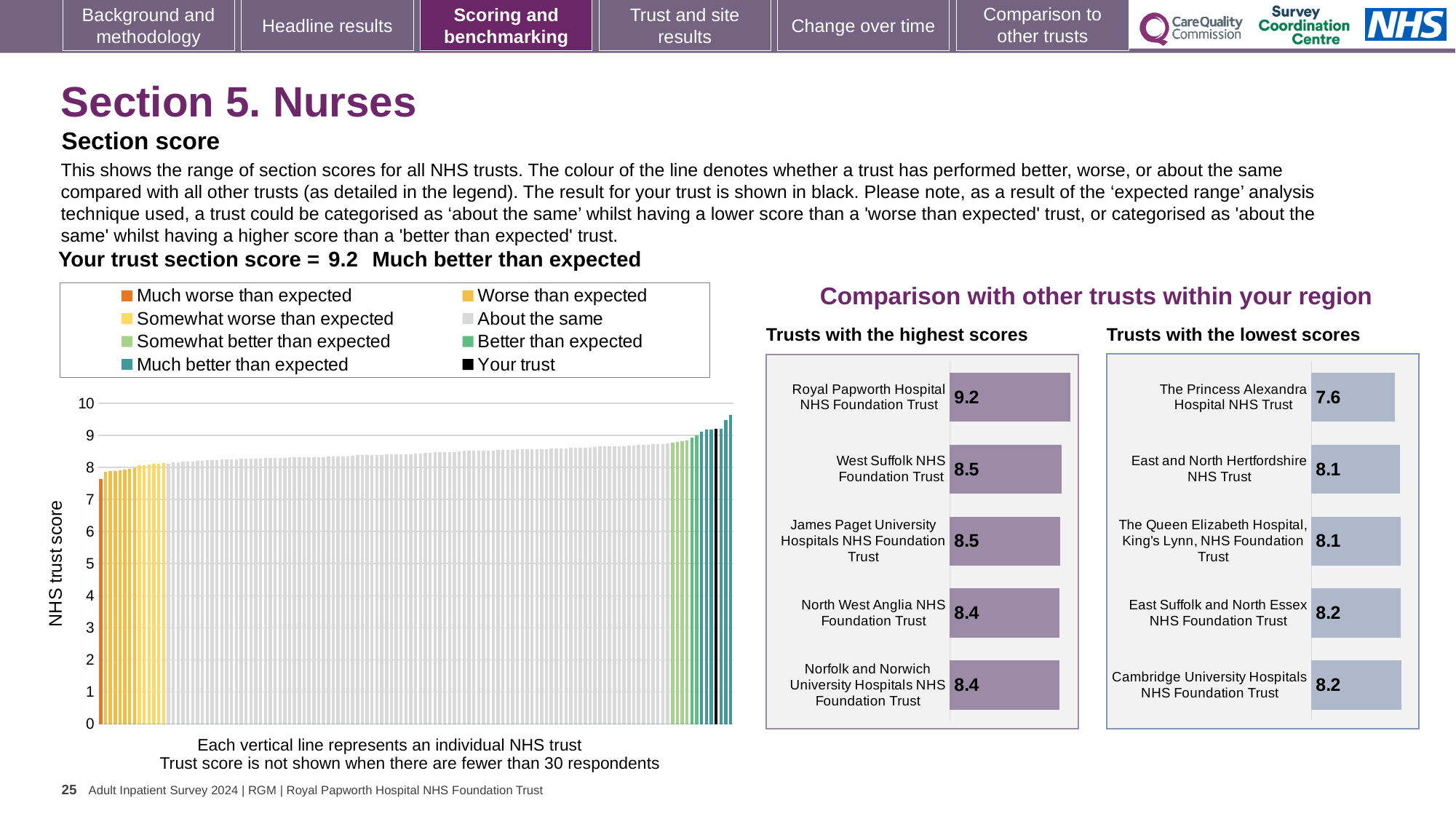
What kind of chart is the large 'NHS trust score' chart on the left of the slide? Bar chart In the 'Trusts with the lowest scores' chart, which trust has the lowest score? The Princess Alexandra Hospital NHS Trust In the 'Trusts with the highest scores' chart, which trust has the highest score? Royal Papworth Hospital NHS Foundation Trust In the 'Trusts with the highest scores' chart, what is the score for Royal Papworth Hospital NHS Foundation Trust? 9.2 How many entries does the legend of the large 'NHS trust score' chart list? 8 In the 'Trusts with the lowest scores' chart, what is the score for The Princess Alexandra Hospital NHS Trust? 7.6 Which has the higher score: North West Anglia NHS Foundation Trust in the highest scores chart or The Princess Alexandra Hospital NHS Trust in the lowest scores chart? North West Anglia NHS Foundation Trust In the 'Trusts with the lowest scores' chart, what is the score for Cambridge University Hospitals NHS Foundation Trust? 8.2 In the 'Trusts with the highest scores' chart, what is the difference between the scores of Royal Papworth Hospital NHS Foundation Trust and West Suffolk NHS Foundation Trust? 0.7 In the large 'NHS trust score' chart, is the value of the leftmost (orange) bar greater or less than 8? less In the 'Trusts with the lowest scores' chart, what is the difference between the scores of East Suffolk and North Essex NHS Foundation Trust and The Princess Alexandra Hospital NHS Trust? 0.6 How many trusts are shown in the 'Trusts with the highest scores' chart? 5